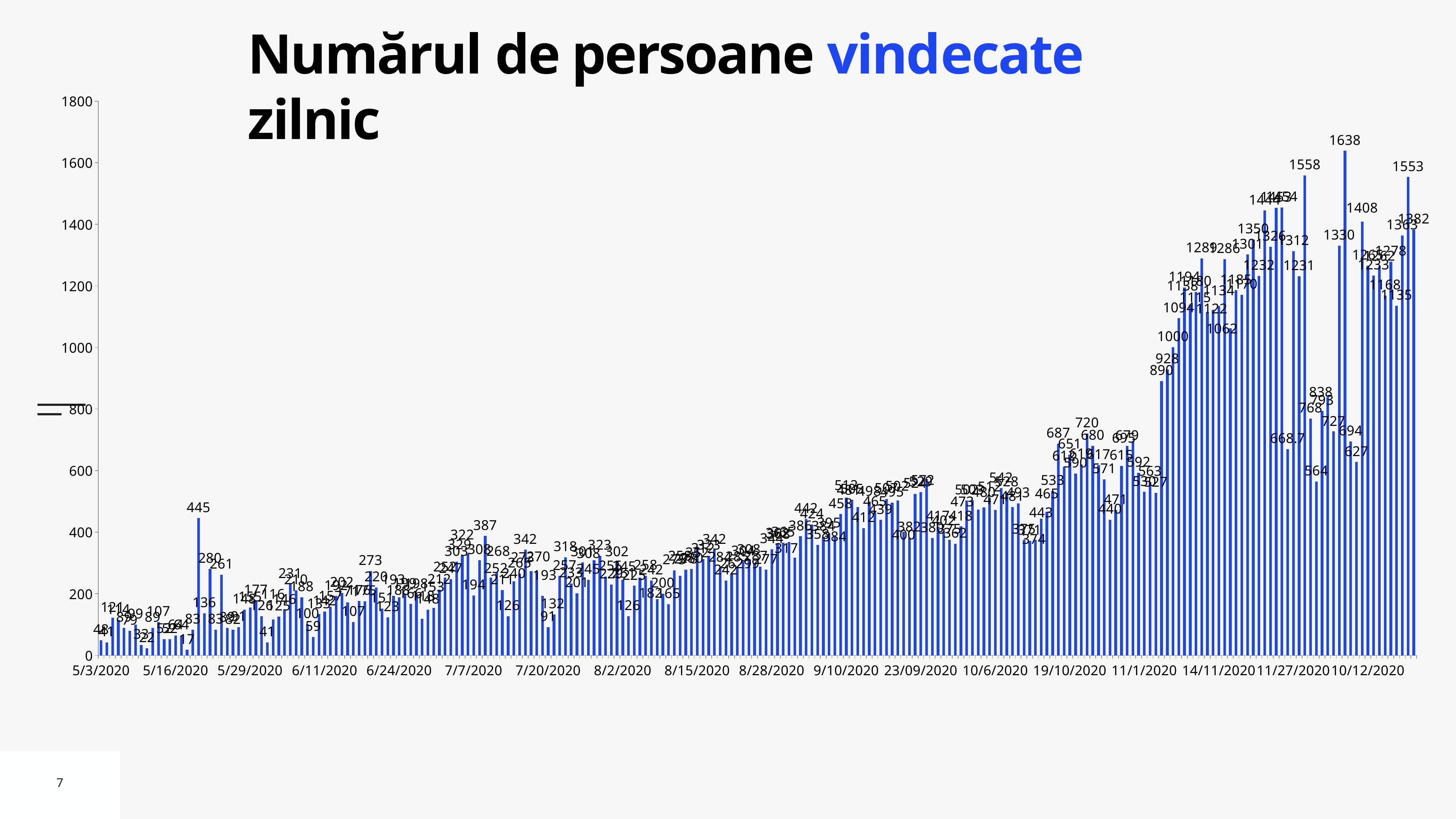
What is the lowest value labeled on the chart? 17 What kind of chart is shown on the slide? bar chart Which is larger, the bar labeled 445 or the bar labeled 387? 445 What is the highest value labeled on the chart? 1638 Overall, do the values rise or fall from left to right along the x axis? rise What is the value of the last bar on the right of the chart? 1382 What is the title of the chart? Numărul de persoane vindecate zilnic What is the difference between the highest labeled value (1638) and the bar labeled 1558? 80 Is the value of the first bar (5/3/2020) greater or less than 200? less What is the maximum value shown on the vertical axis? 1800 What is the value of the tallest bar before 6/11/2020? 445 Is the tallest bar on the chart greater or less than 1600? greater